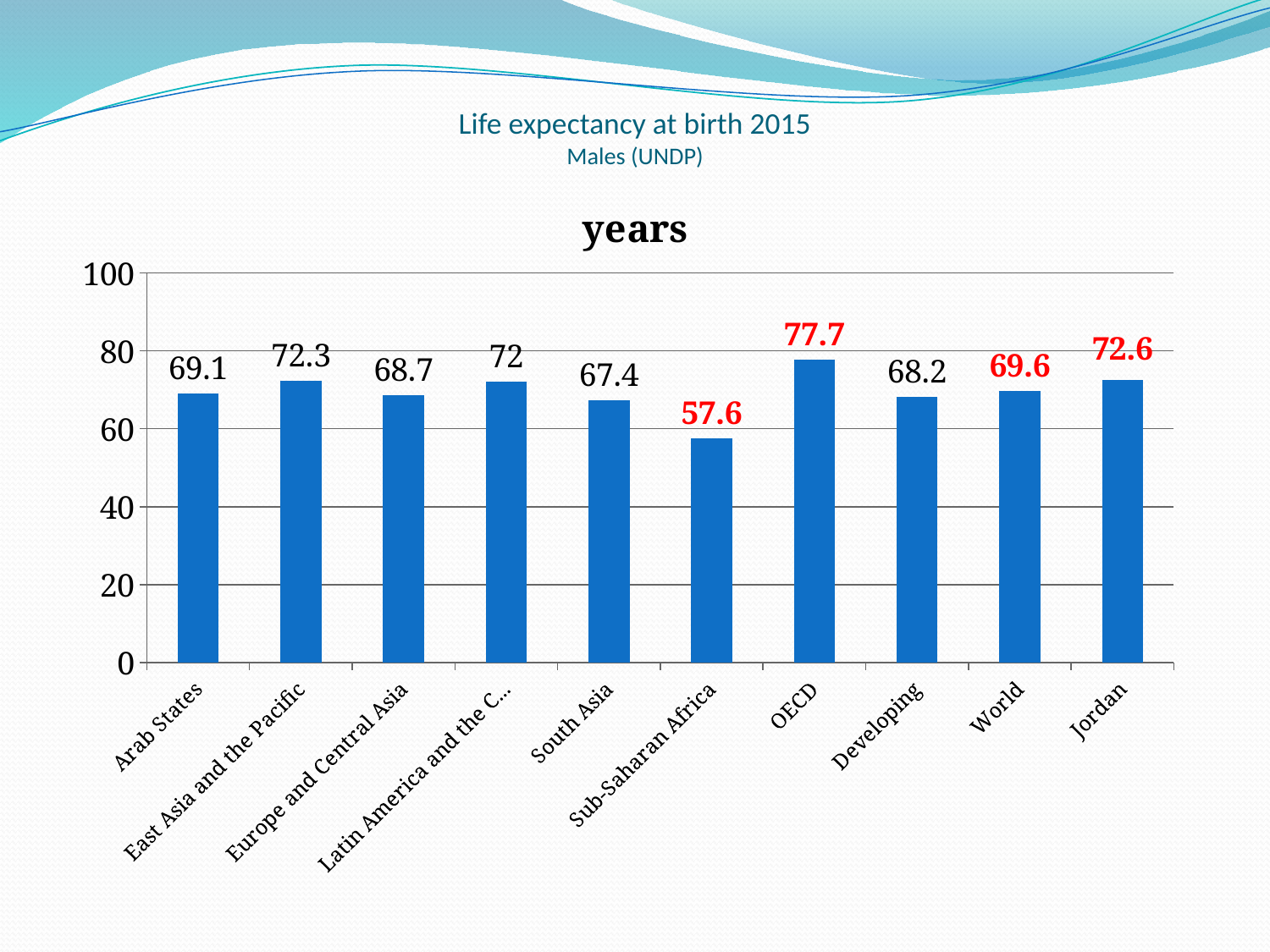
What is the value for World? 69.6 What is the title of the chart? years Which is larger, the value for East Asia and the Pacific or the value for Arab States? East Asia and the Pacific What is the difference between the values for Jordan and World? 3 What is the value for South Asia? 67.4 What is the value for Jordan? 72.6 What is the difference between the values for OECD and Sub-Saharan Africa? 20.1 What kind of chart is shown on the slide? Bar chart How many categories are shown on the x axis? 10 Which category has the lowest value? Sub-Saharan Africa What is the value for Sub-Saharan Africa? 57.6 Which category has the highest value? OECD